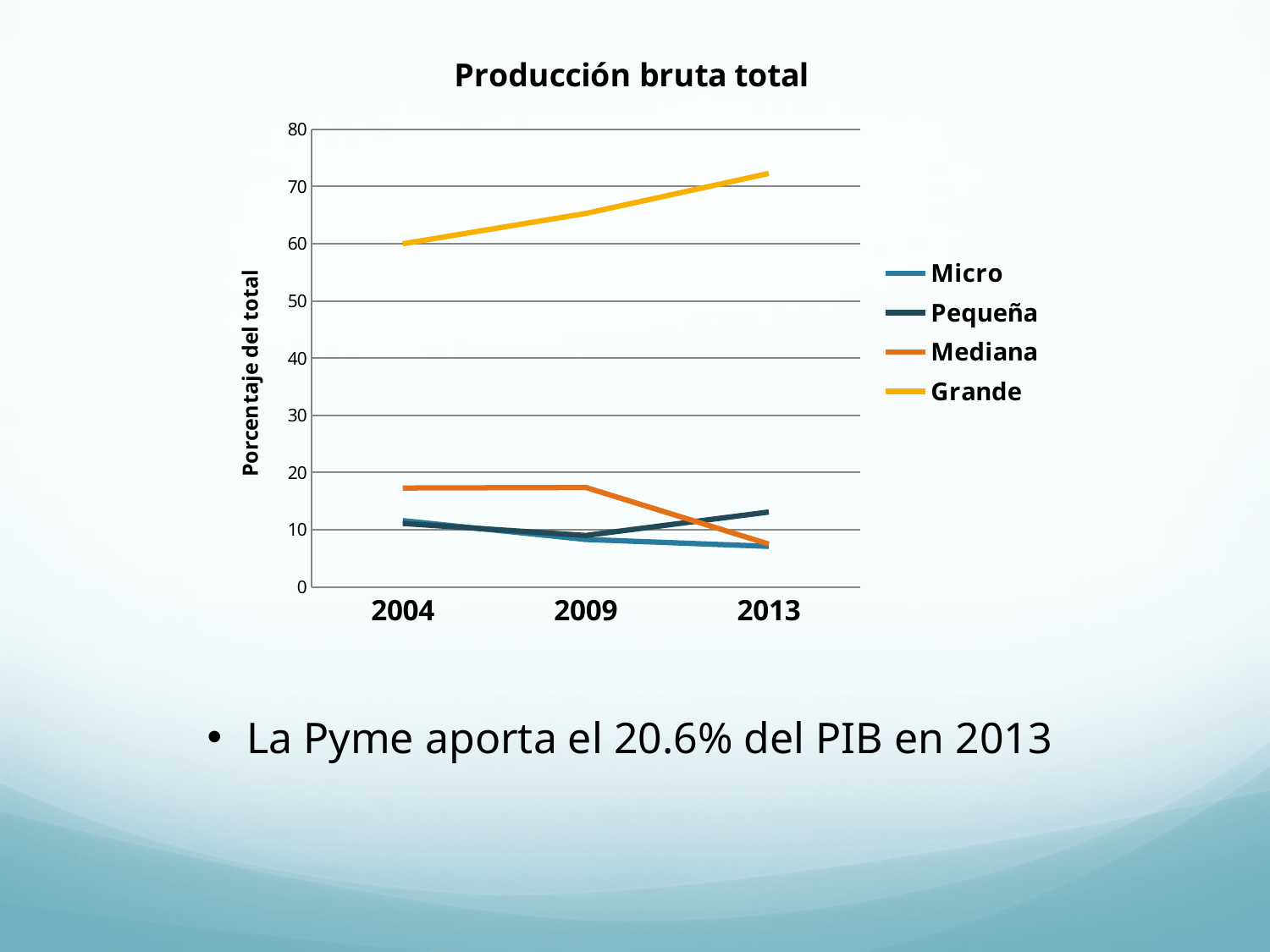
How many series does the legend list? 4 Which series has the highest value in 2004? Grande Is the value for Grande in 2013 greater or less than 70? greater Does the Grande series rise or fall from 2004 to 2013? rise In 2009, which is larger, Mediana or Pequeña? Mediana Which series has the highest value in 2013? Grande Does the Mediana series rise or fall from 2009 to 2013? fall Is the value for Mediana in 2004 greater or less than 20? less What kind of chart is shown on the slide? line chart What is the title of the chart? Producción bruta total Is the value for Pequeña in 2013 greater or less than 10? greater How many years are plotted along the x axis? 3